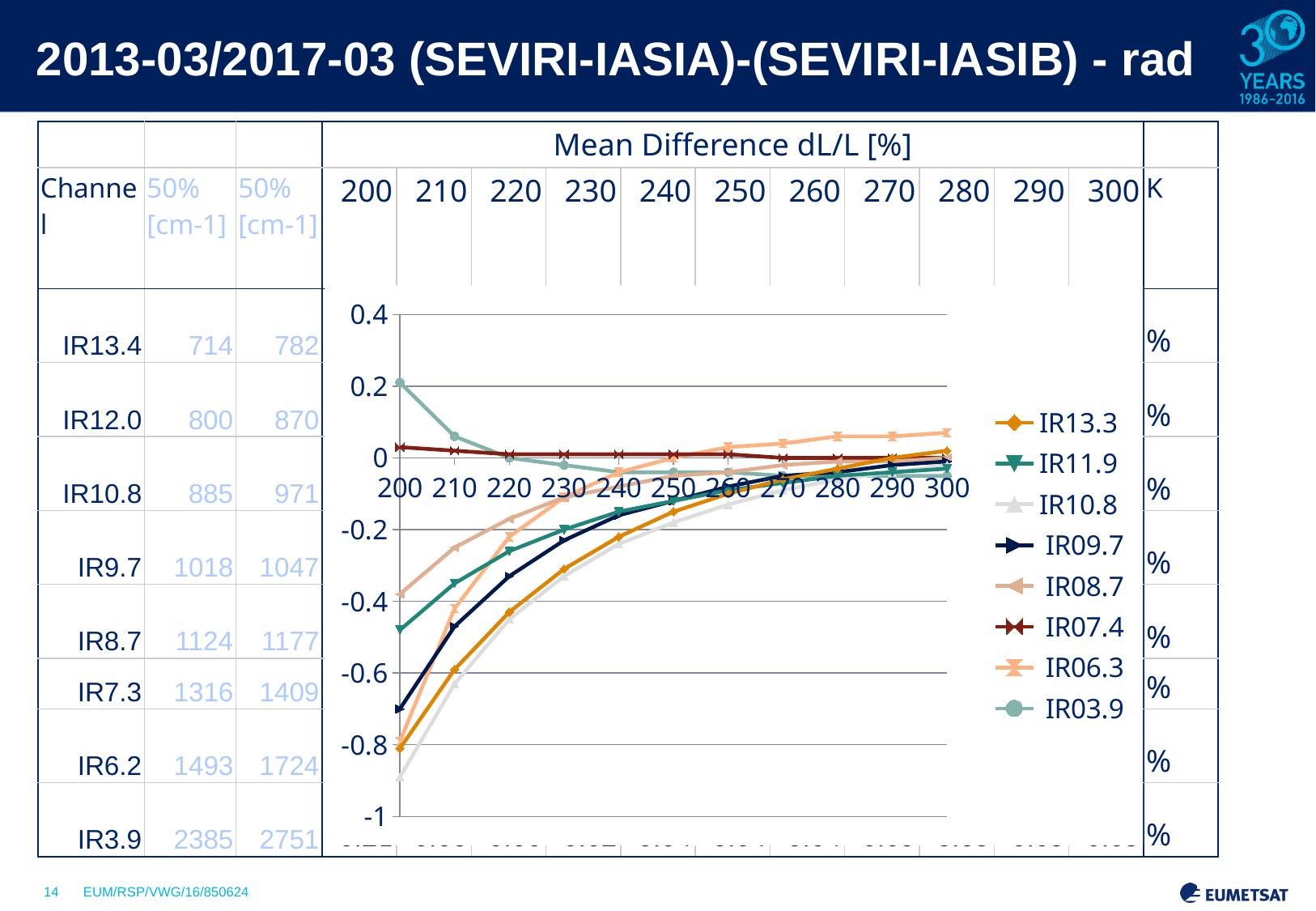
What kind of chart is shown on the slide? line chart Which series has the lowest value at x = 200? IR10.8 How many x-axis points (from 200 to 300) does each series have? 11 Does the IR13.3 series rise or fall as x increases from 200 to 300? rise Does the IR03.9 series rise or fall as x increases from 200 to 300? fall What is the title shown above the chart? Mean Difference dL/L [%] At x = 200, which is larger: the value for IR11.9 or the value for IR09.7? IR11.9 Which series has the highest value at x = 200? IR03.9 How many series does the chart legend list? 8 Is the value for IR03.9 at x = 200 greater or less than 0? greater Is the value for IR10.8 at x = 200 greater or less than -0.8? less Is the value for IR09.7 at x = 200 greater or less than -0.6? less